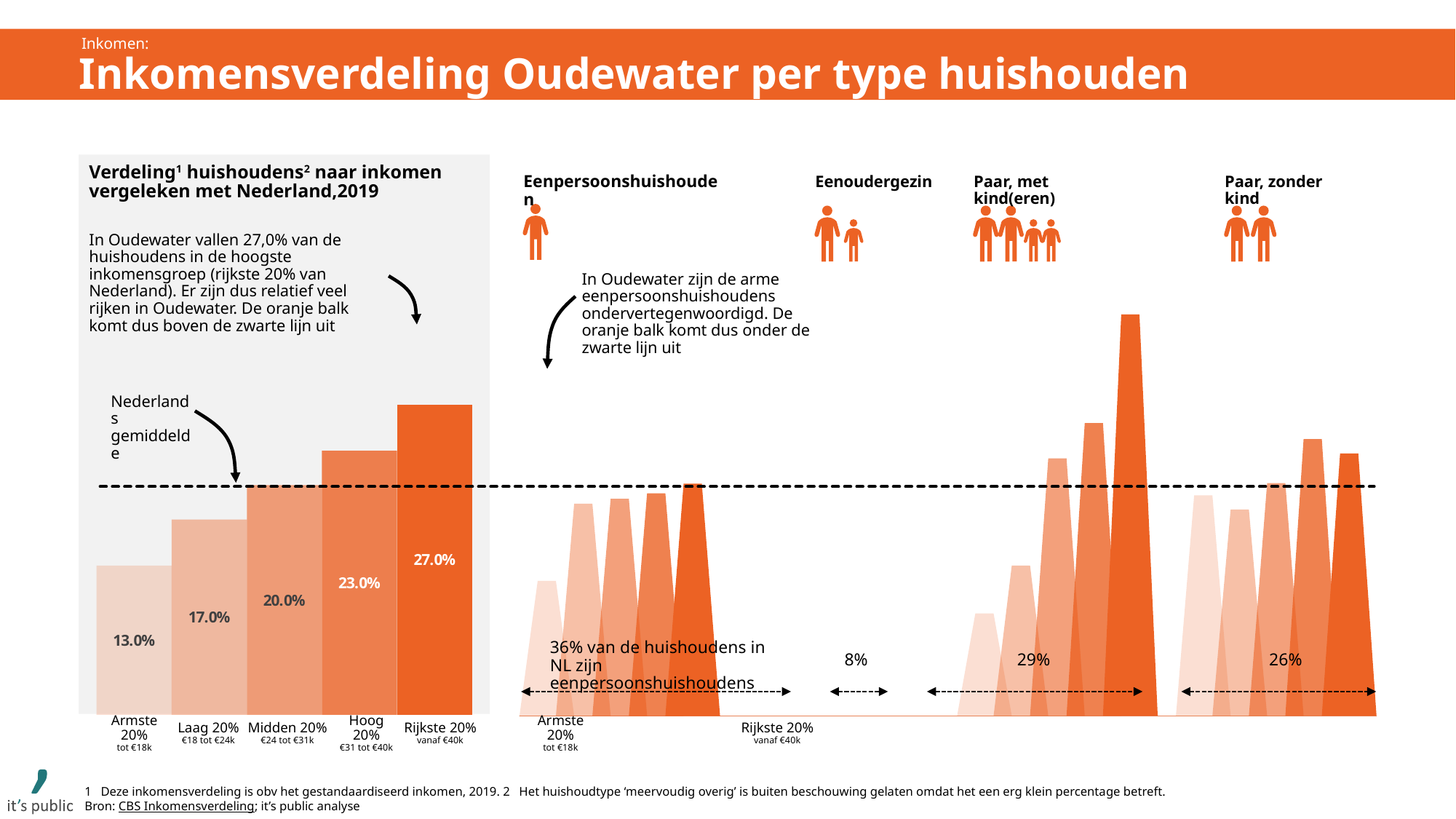
In the left chart, which is larger: the value for Hoog 20% or the value for Midden 20%? Hoog 20% How many household types are shown in the right-hand chart? 4 In the left chart, what is the value for Midden 20%? 20.0% In the left chart 'Verdeling huishoudens naar inkomen vergeleken met Nederland, 2019', what is the value for Rijkste 20%? 27.0% In the left chart, what is the difference between the values for Rijkste 20% and Armste 20%? 14.0 percentage points What kind of chart is the left chart? Bar chart In the left chart, what is the value for Armste 20%? 13.0% In the left chart, which income group has the lowest value? Armste 20% In the left chart, what is the value for Laag 20%? 17.0% In the left chart, do the values rise or fall from Armste 20% to Rijkste 20%? Rise How many income groups are shown in the left chart? 5 In the left chart, which income group has the highest value? Rijkste 20%